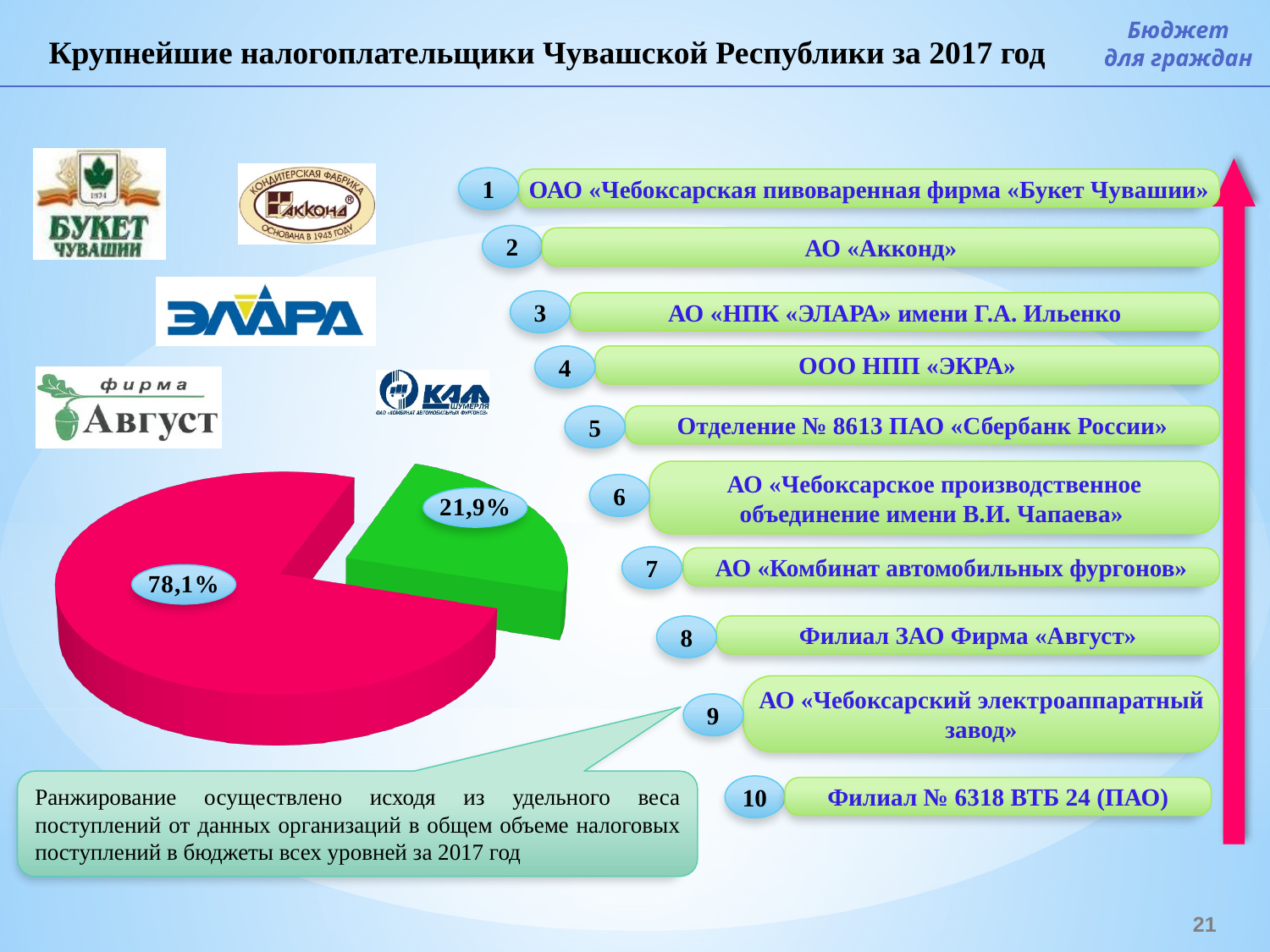
Is the value of the green slice of the pie chart greater or less than 25%? less Which slice of the pie chart is the smallest? the green slice (21,9%) What value is printed on the green slice of the pie chart? 21,9% What do the two slices of the pie chart add up to? 100% Which slice of the pie chart is the largest? the pink slice (78,1%) Is the value of the pink slice of the pie chart greater or less than 75%? greater Which is larger in the pie chart, the pink slice or the green slice? the pink slice What is the difference between the pink slice and the green slice of the pie chart? 56,2% Which slice of the pie chart is pulled out (exploded) from the rest of the pie? the green slice (21,9%) How many slices does the pie chart have? 2 What kind of chart is shown on the slide? pie chart What value is printed on the pink slice of the pie chart? 78,1%